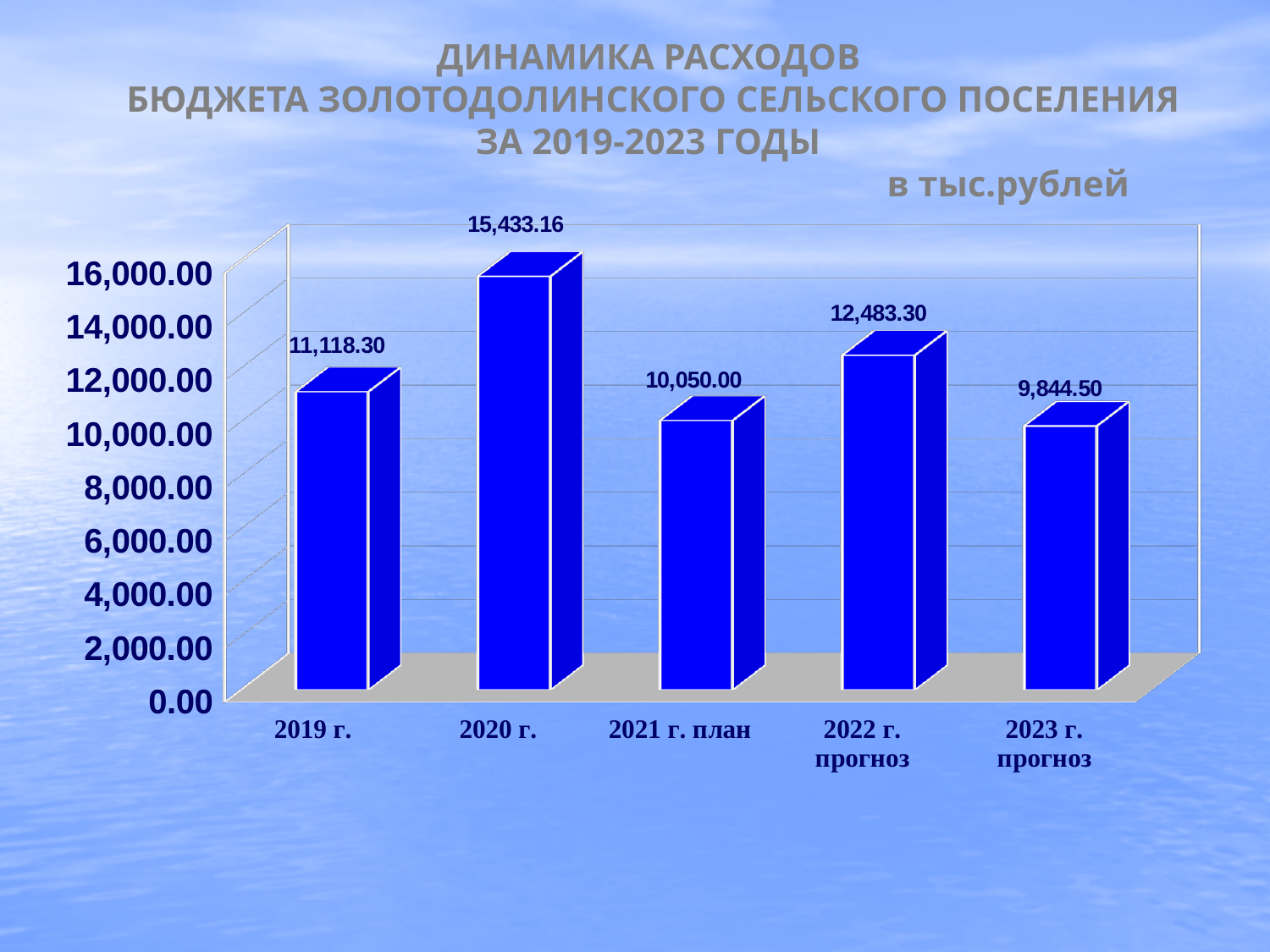
Which category has the highest value? 2020 г. What is the difference between the values for 2022 г. прогноз and 2021 г. план? 2,433.30 What is the value for 2021 г. план? 10,050.00 What is the value for 2019 г.? 11,118.30 What kind of chart is shown on the slide? bar chart What is the value for 2023 г. прогноз? 9,844.50 Which category has the lowest value? 2023 г. прогноз What is the difference between the values for 2020 г. and 2019 г.? 4,314.86 Is the value for 2020 г. greater or less than 14,000.00? greater How many categories are shown on the x axis? 5 In what units are the values on the chart expressed? тыс.рублей Which is larger, the value for 2022 г. прогноз or the value for 2019 г.? 2022 г. прогноз